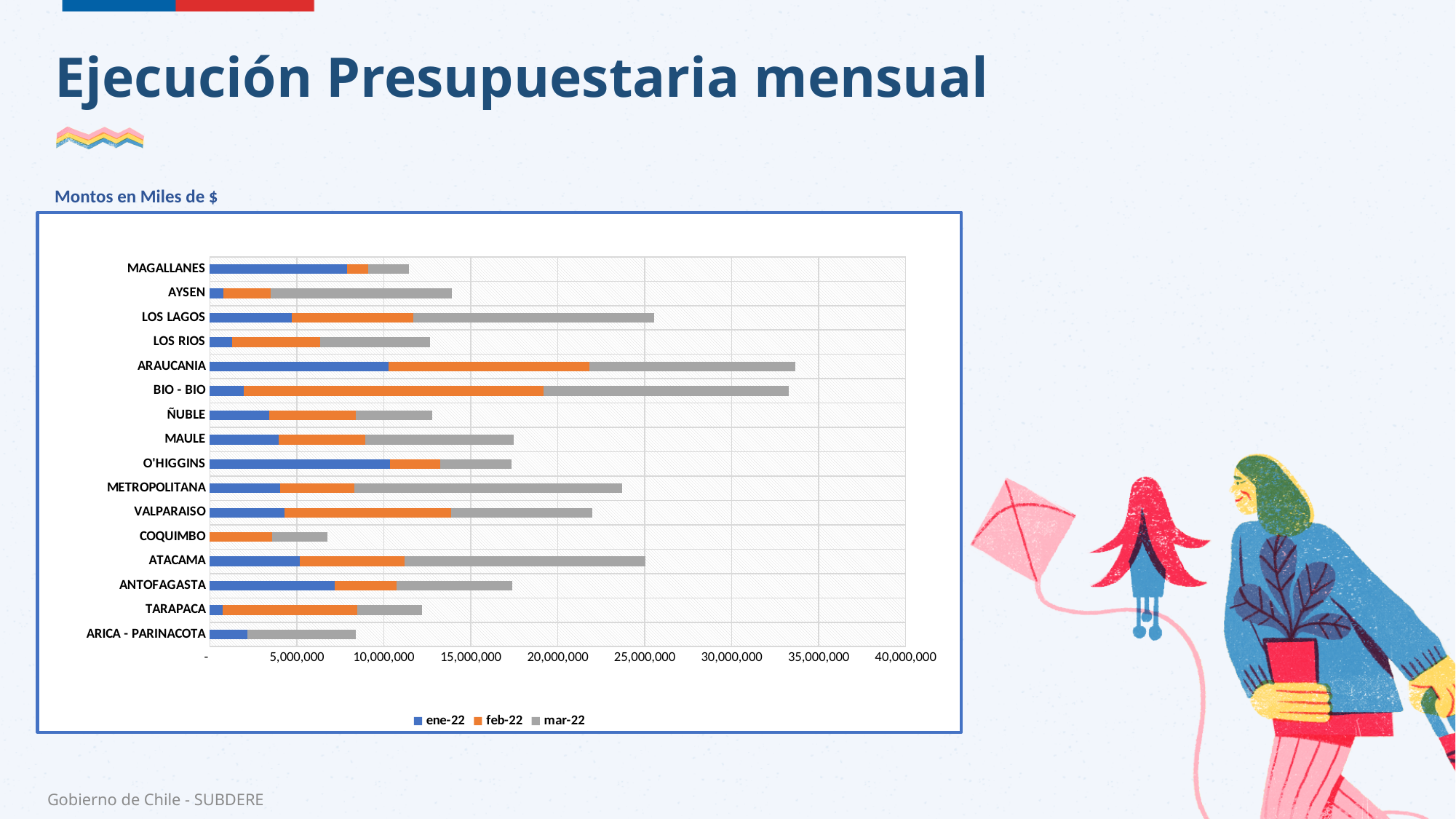
Which has the larger ene-22 segment, O'HIGGINS or AYSEN? O'HIGGINS How many regions are listed on the vertical axis of the chart? 16 Which series are listed in the chart legend? ene-22, feb-22, mar-22 Is the total bar for COQUIMBO greater or less than 10,000,000? less Which region has the shortest total bar in the chart? COQUIMBO Which region has the largest feb-22 segment in the chart? BIO - BIO Is the total bar for METROPOLITANA greater or less than 25,000,000? less Which has the larger total bar, ARAUCANIA or LOS LAGOS? ARAUCANIA Is the total bar for AYSEN greater or less than 10,000,000? greater What kind of chart is shown on the slide? Stacked bar chart How many series does the chart legend list? 3